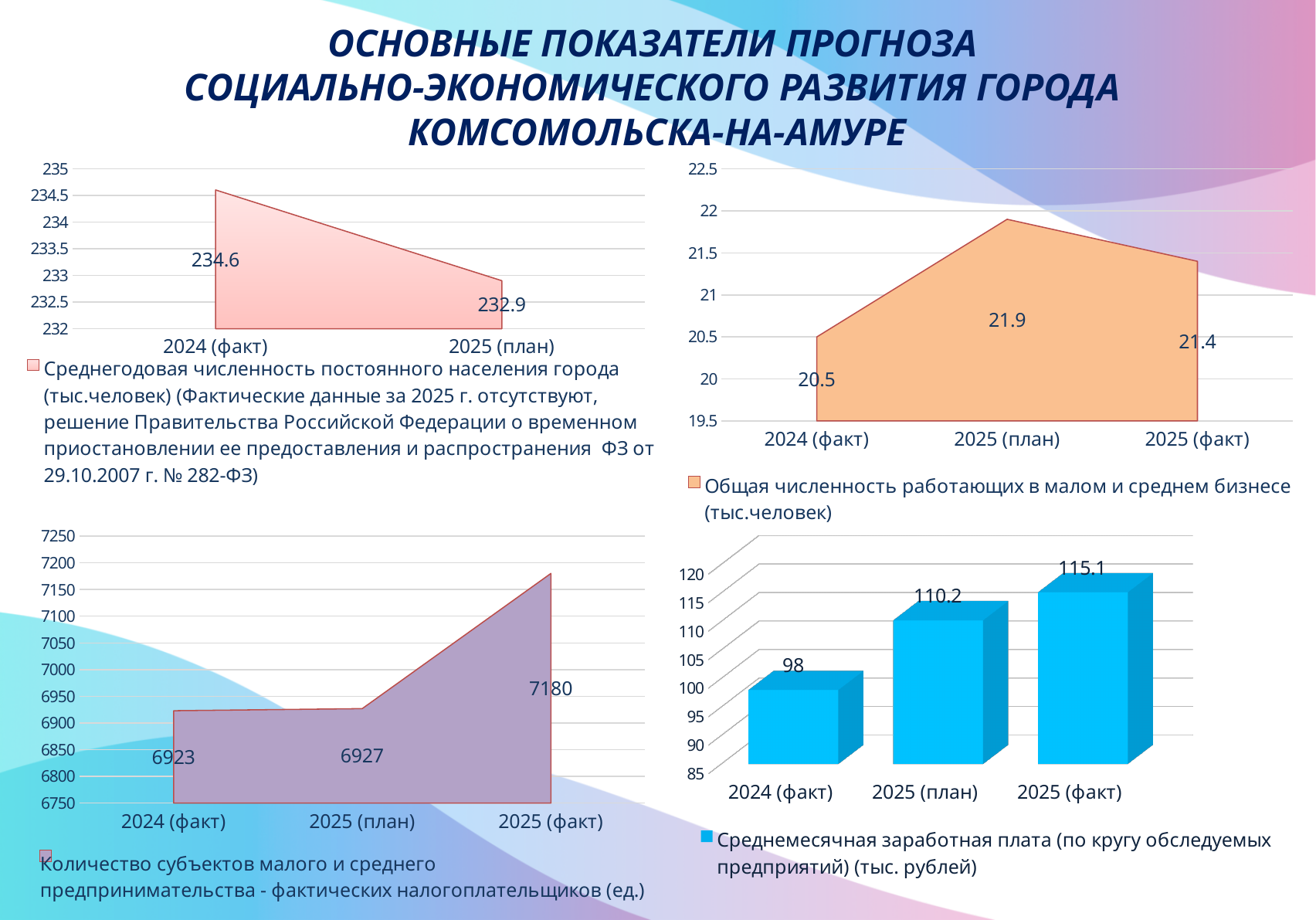
On the top-left chart (average annual population), what is the value for 2024 (факт)? 234.6 On the bottom-left chart (number of small and medium business entities), how many categories are shown on the x axis? 3 On the top-left chart (average annual population), what is the difference between the 2024 (факт) and 2025 (план) values? 1.7 On the bottom-right chart (average monthly salary), which category has the highest value? 2025 (факт) On the bottom-left chart (number of small and medium business entities), what is the value for 2025 (факт)? 7180 On the bottom-left chart (number of small and medium business entities), what is the difference between 2025 (факт) and 2024 (факт)? 257 On the top-right chart (employees in small and medium business), what is the value for 2025 (план)? 21.9 On the top-right chart (employees in small and medium business), which category has the lowest value? 2024 (факт) On the top-right chart (employees in small and medium business), which is larger: 2025 (план) or 2025 (факт)? 2025 (план) What type of chart is the bottom-right chart (average monthly salary)? Bar chart On the top-left chart (average annual population), what is the value for 2025 (план)? 232.9 On the bottom-right chart (average monthly salary), what is the value for 2024 (факт)? 98